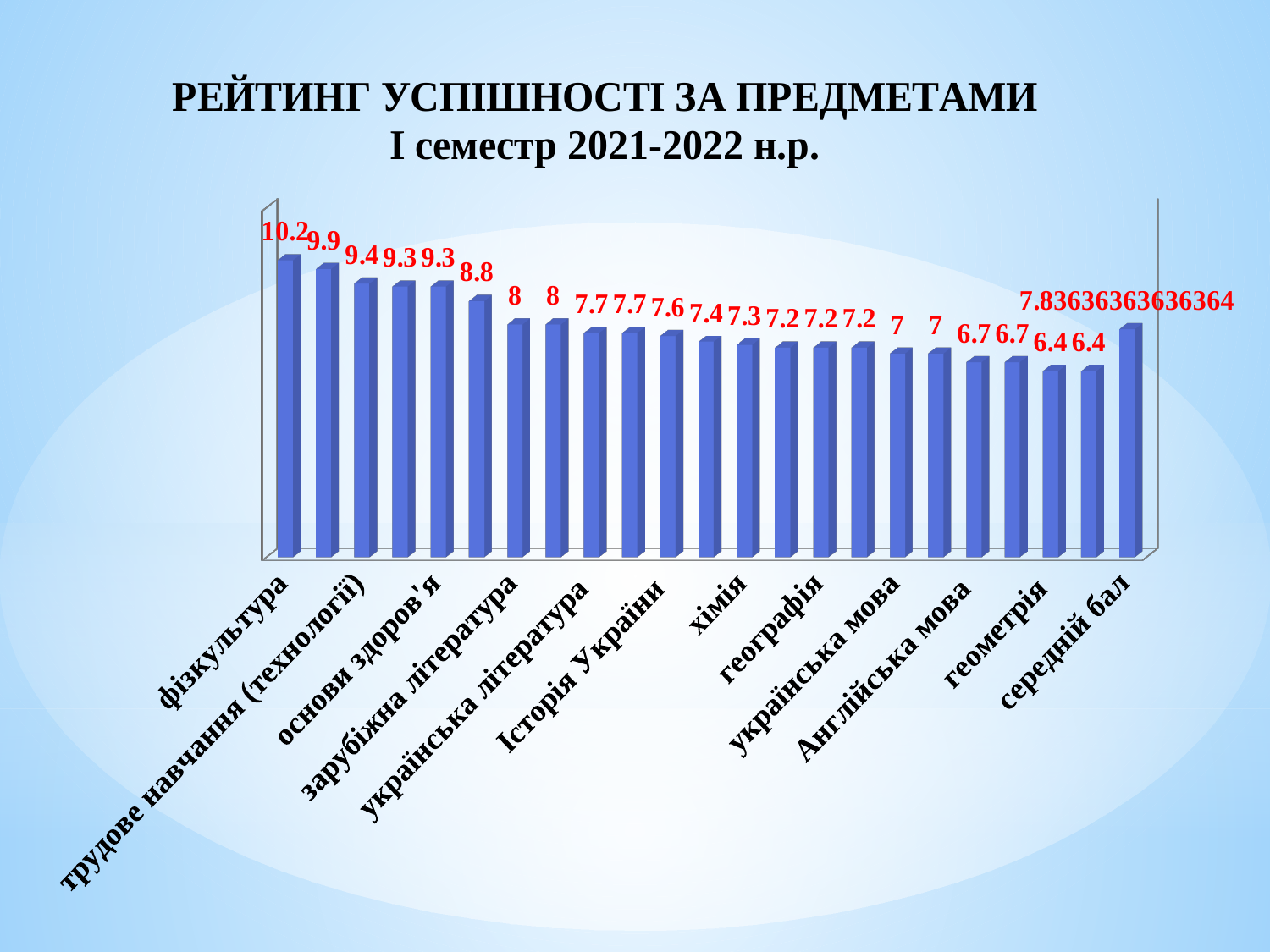
Do the values generally rise or fall from left to right across the subject bars (excluding the final середній бал bar)? fall What is the value shown for середній бал? 7.836363636363636364 What is the lowest value labelled on any bar in the chart? 6.4 What is the value shown for фізкультура? 10.2 What is the title of the chart on the slide? РЕЙТИНГ УСПІШНОСТІ ЗА ПРЕДМЕТАМИ І семестр 2021-2022 н.р. What is the value shown for геометрія? 6.4 Which subject has the highest value in the chart? фізкультура What kind of chart is shown on the slide? bar chart What is the difference between the value for фізкультура and the value for геометрія? 3.8 Which is larger, the value for основи здоров'я or the value for хімія? основи здоров'я What is the value shown for трудове навчання (технології)? 9.4 How many bars are plotted in the chart? 23